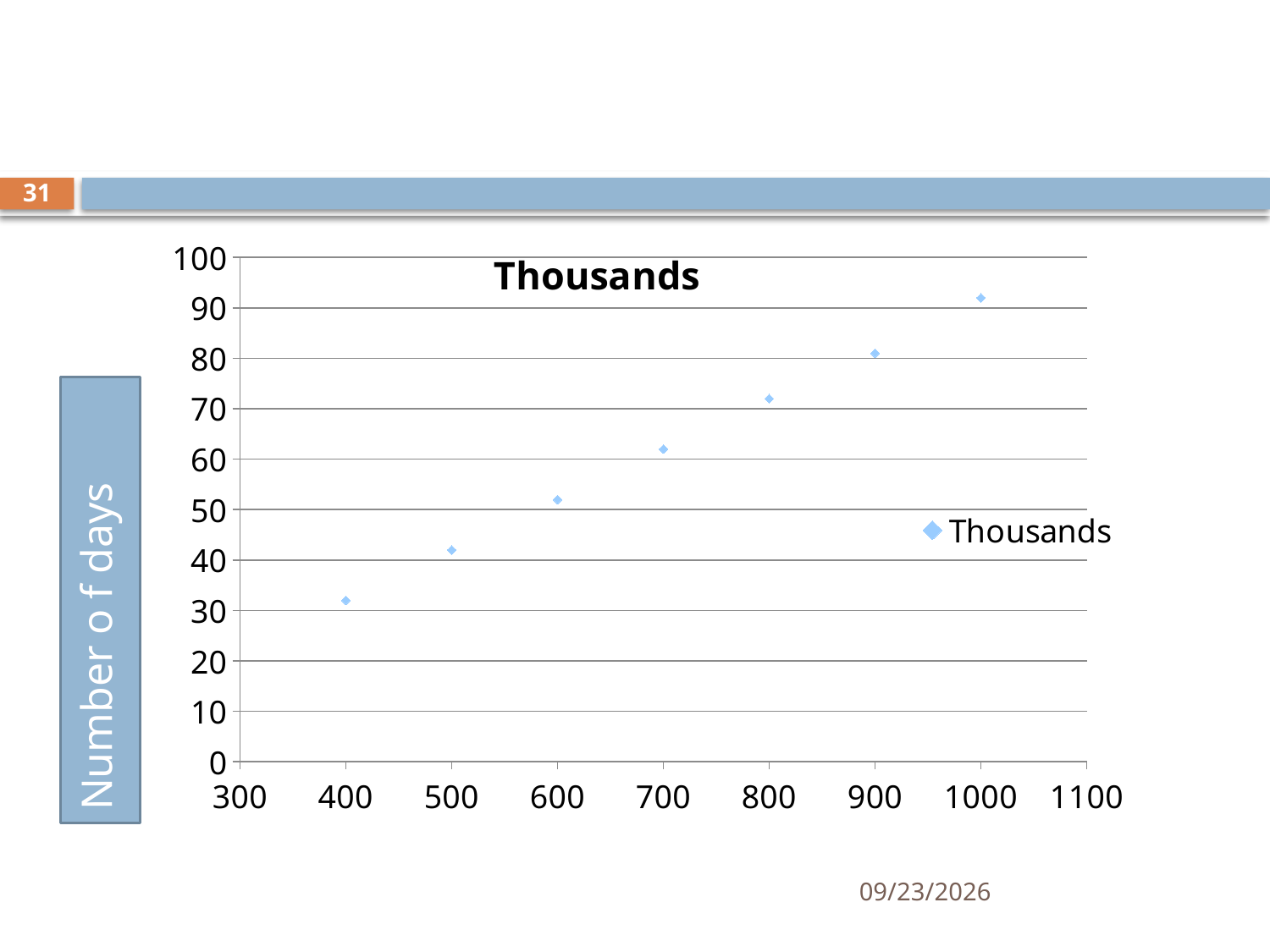
At which x-axis value is the plotted point highest? 1000 What is the label on the vertical axis of the chart? Number o f days Do the plotted values rise or fall as the x-axis value increases from 400 to 1000? rise What is the title of the chart? Thousands What kind of chart is shown on the slide? scatter chart How many data points are plotted on the chart? 7 At which x-axis value is the plotted point lowest? 400 How many series does the legend list? 1 Is the value plotted at x = 700 greater or less than 50? greater Which has the larger plotted value, x = 900 or x = 500? 900 Is the value plotted at x = 400 greater or less than 40? less Is the value plotted at x = 1000 greater or less than 80? greater